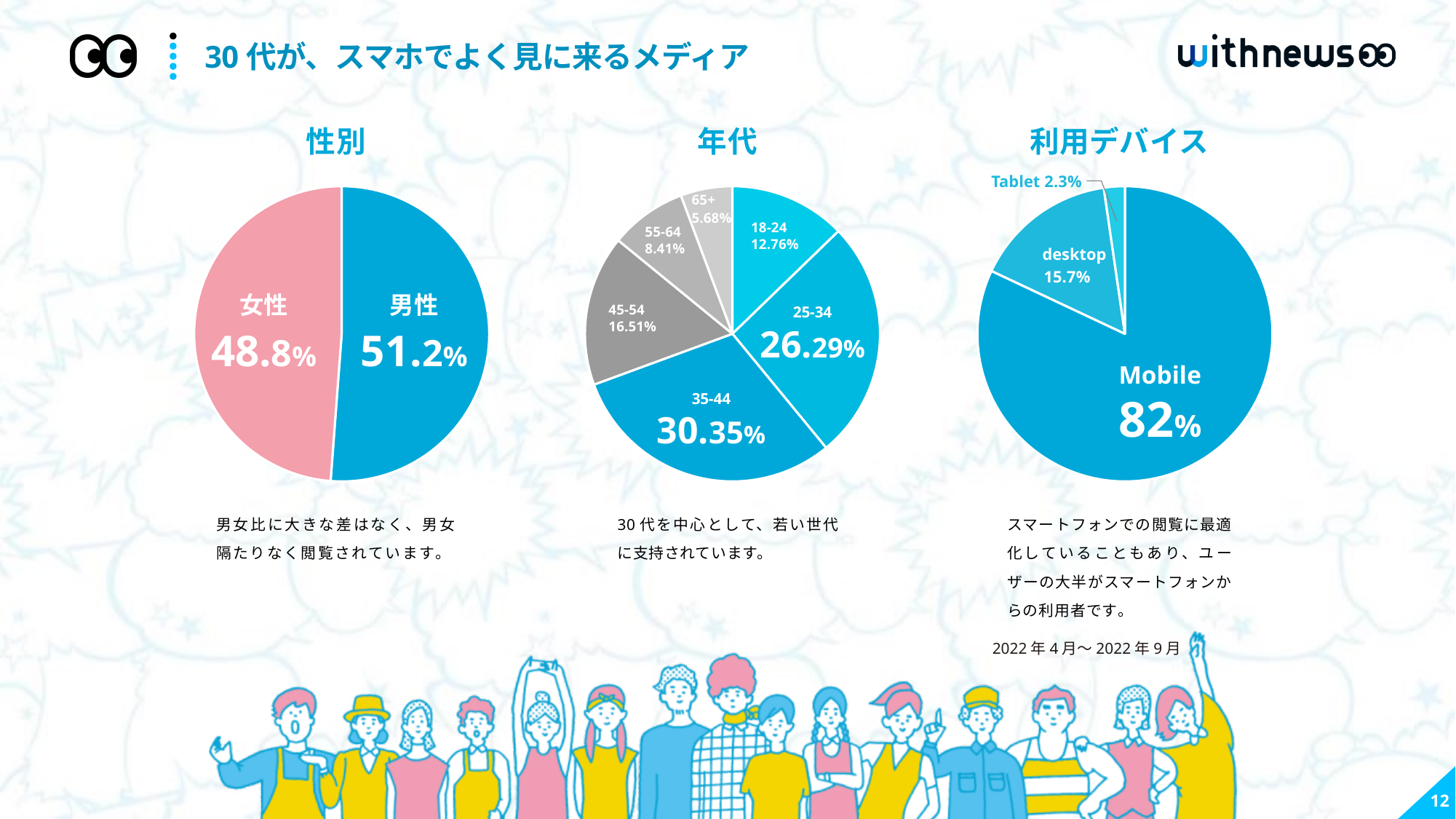
In the 性別 pie chart, what share is labelled for 男性? 51.2% In the 年代 pie chart, what share is labelled for the 35-44 age group? 30.35% What kind of chart is used for 利用デバイス? Pie chart In the 年代 pie chart, which age group has the largest share? 35-44 In the 性別 pie chart, what share is labelled for 女性? 48.8% In the 年代 pie chart, which age group has the smallest share? 65+ In the 利用デバイス pie chart, what share is labelled for Mobile? 82% In the 性別 pie chart, what is the difference between the 男性 and 女性 shares? 2.4% In the 性別 pie chart, which is larger, 男性 or 女性? 男性 How many age groups are shown in the 年代 pie chart? 6 In the 利用デバイス pie chart, what is the difference between the desktop and Tablet shares? 13.4% In the 年代 pie chart, what share is labelled for the 18-24 age group? 12.76%